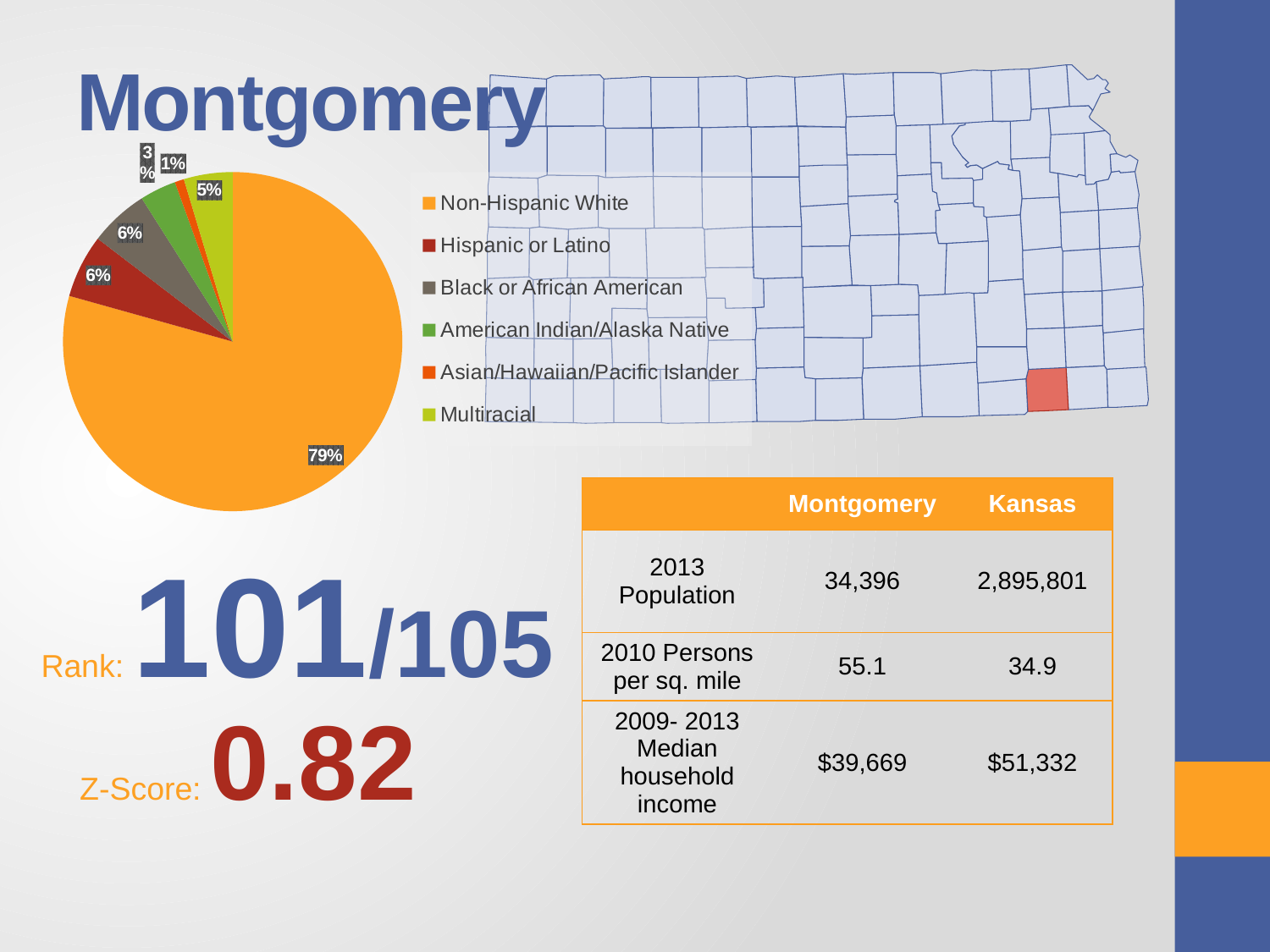
How many categories does the pie chart legend list? 6 Which category has the smallest slice of the pie chart? Asian/Hawaiian/Pacific Islander What percentage of the pie chart is Multiracial? 5% What type of chart is shown on the slide? pie chart What percentage of the pie chart is Black or African American? 6% What is the difference in percentage points between the Non-Hispanic White slice and the Multiracial slice? 74 What percentage of the pie chart is Hispanic or Latino? 6% Which category has the largest slice of the pie chart? Non-Hispanic White Which slice is larger, Multiracial or American Indian/Alaska Native? Multiracial What percentage of the pie chart is Asian/Hawaiian/Pacific Islander? 1% What percentage of the pie chart is American Indian/Alaska Native? 3% What percentage of the pie chart is Non-Hispanic White? 79%